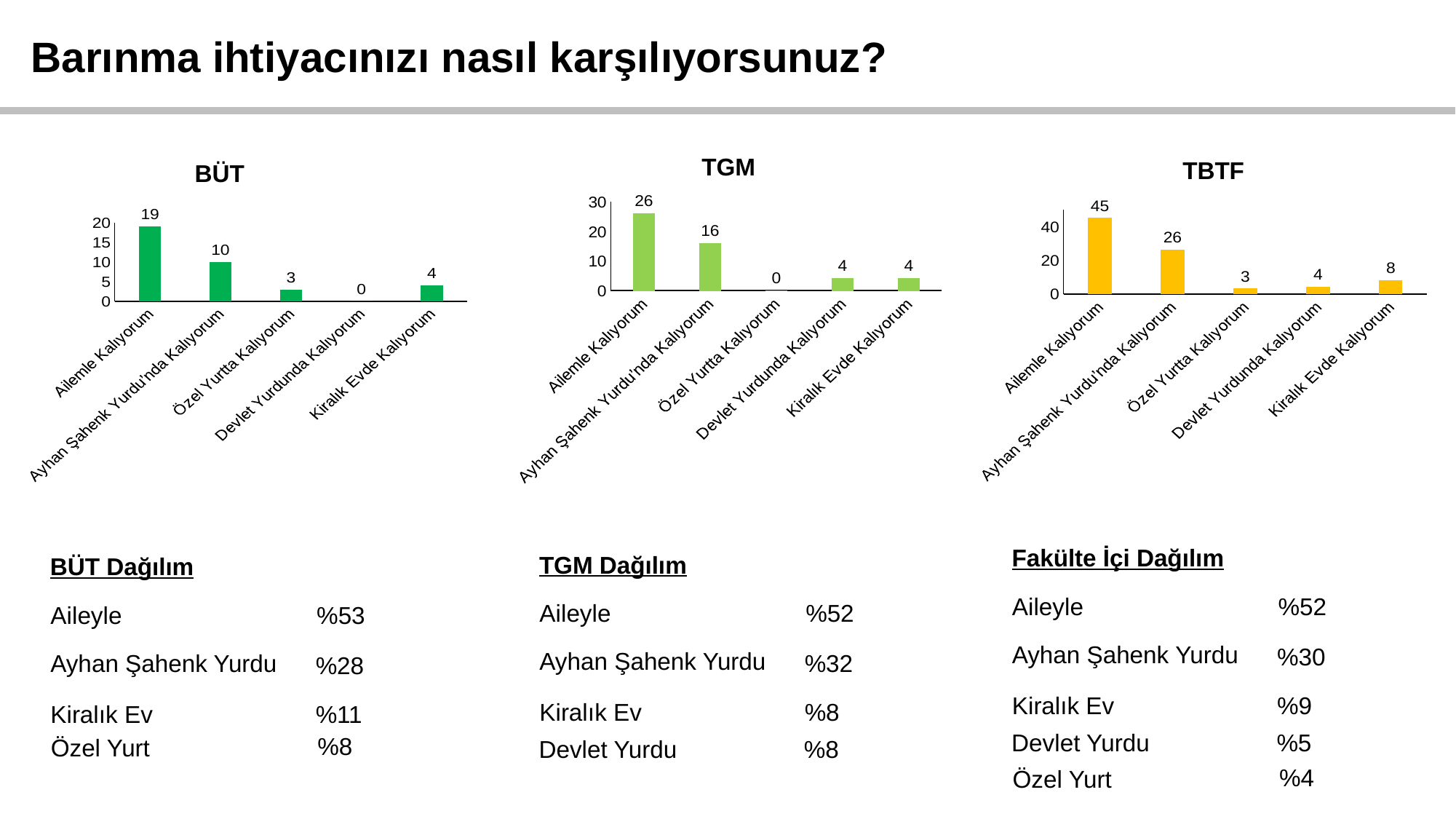
In the BÜT chart, which category has the lowest value? Devlet Yurdunda Kalıyorum How many categories does the TGM chart show? 5 In the TBTF chart, what is the value for Kiralık Evde Kalıyorum? 8 In the TBTF chart, which category has the highest value? Ailemle Kalıyorum In the TGM chart, what is the value for Ayhan Şahenk Yurdu'nda Kalıyorum? 16 In the TBTF chart, what is the difference between Ailemle Kalıyorum and Ayhan Şahenk Yurdu'nda Kalıyorum? 19 In the BÜT chart, which is larger: Ayhan Şahenk Yurdu'nda Kalıyorum or Kiralık Evde Kalıyorum? Ayhan Şahenk Yurdu'nda Kalıyorum In the TGM chart, what is the value for Özel Yurtta Kalıyorum? 0 In the BÜT chart, what is the value for Ailemle Kalıyorum? 19 What kind of chart is the BÜT chart? Bar chart In the TGM chart, what is the difference between Ailemle Kalıyorum and Ayhan Şahenk Yurdu'nda Kalıyorum? 10 What is the title of the chart on the right of the slide? TBTF